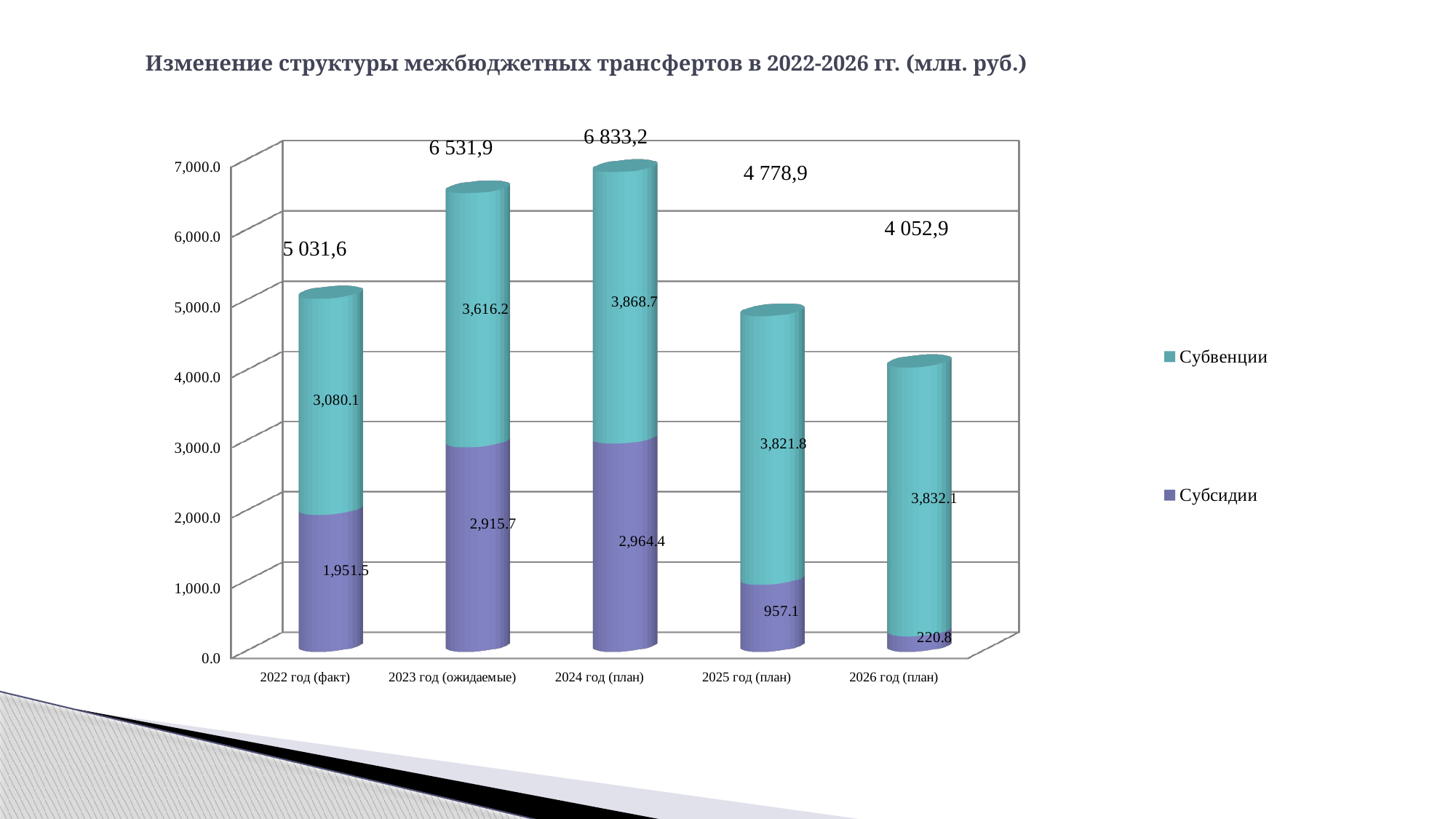
What is the difference between the Субсидии values for 2024 год (план) and 2025 год (план)? 2,007.3 How many years are shown on the x axis? 5 What is the value of Субсидии for 2026 год (план)? 220.8 What is the value of Субвенции for 2024 год (план)? 3,868.7 What kind of chart is shown on the slide? Stacked bar chart Which is larger: Субвенции for 2023 год (ожидаемые) or Субвенции for 2022 год (факт)? Субвенции for 2023 год (ожидаемые) Which year has the highest value of Субвенции? 2024 год (план) What is the value of Субвенции for 2025 год (план)? 3,821.8 Which year has the lowest value of Субсидии? 2026 год (план) How many series does the legend list? 2 What is the value of Субсидии for 2022 год (факт)? 1,951.5 What is the total of the stacked bar for 2024 год (план)? 6 833,2